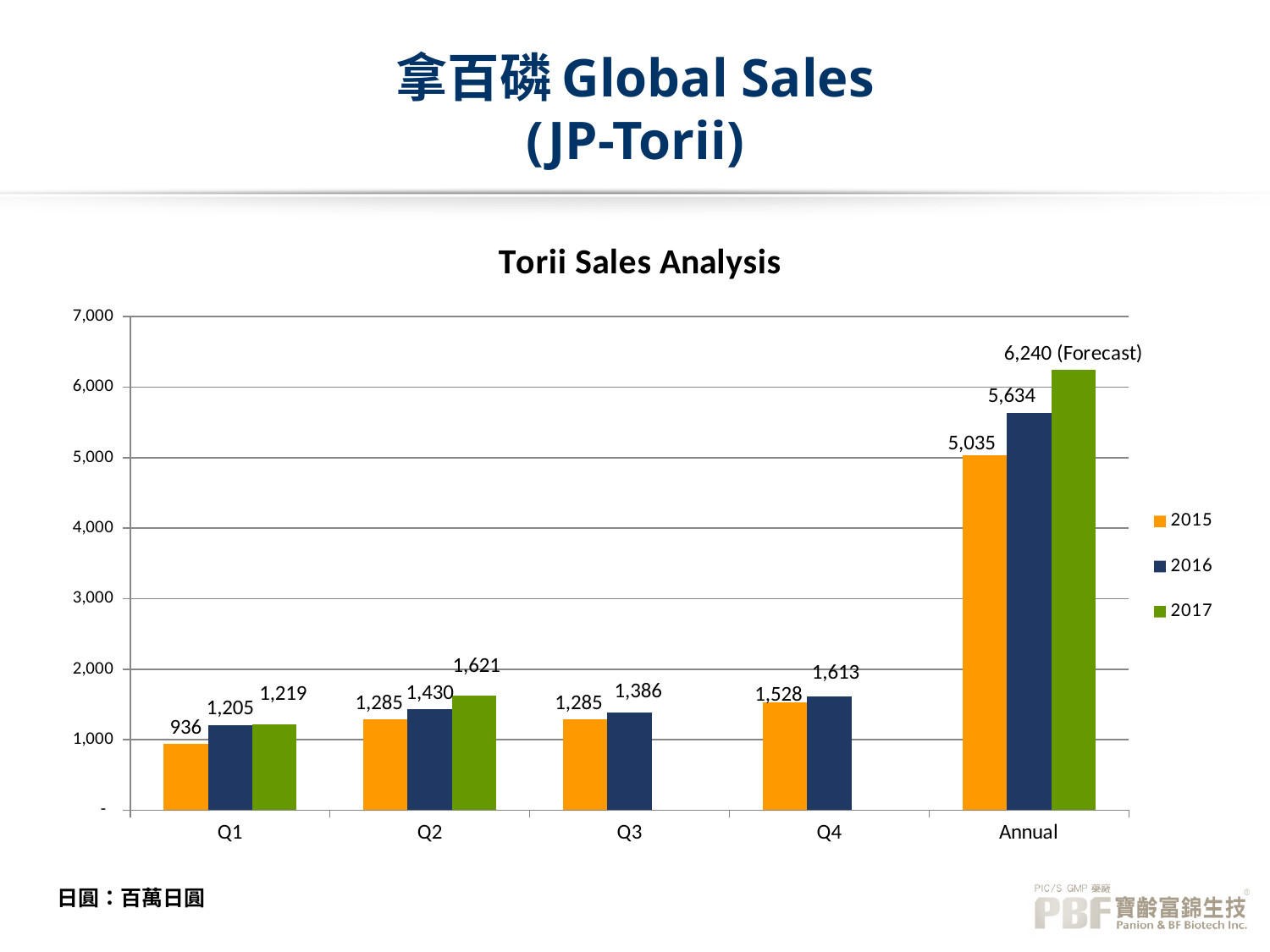
How many series does the legend of the Torii Sales Analysis chart list? 3 What is the 2015 value for Q1 in the Torii Sales Analysis chart? 936 What is the 2016 Annual value in the Torii Sales Analysis chart? 5,634 What is the difference between the 2016 and 2015 Annual values in the Torii Sales Analysis chart? 599 How many categories are shown on the x axis of the Torii Sales Analysis chart? 5 Which quarter has the highest 2015 value in the Torii Sales Analysis chart? Q4 What kind of chart is the Torii Sales Analysis chart? Bar chart Which quarter has the lowest 2016 value in the Torii Sales Analysis chart? Q1 What is the 2017 value for Q2 in the Torii Sales Analysis chart? 1,621 What is the 2016 value for Q4 in the Torii Sales Analysis chart? 1,613 Which series is shown in green in the Torii Sales Analysis chart? 2017 Which is larger in the Torii Sales Analysis chart: the 2016 value for Q2 or the 2016 value for Q3? Q2